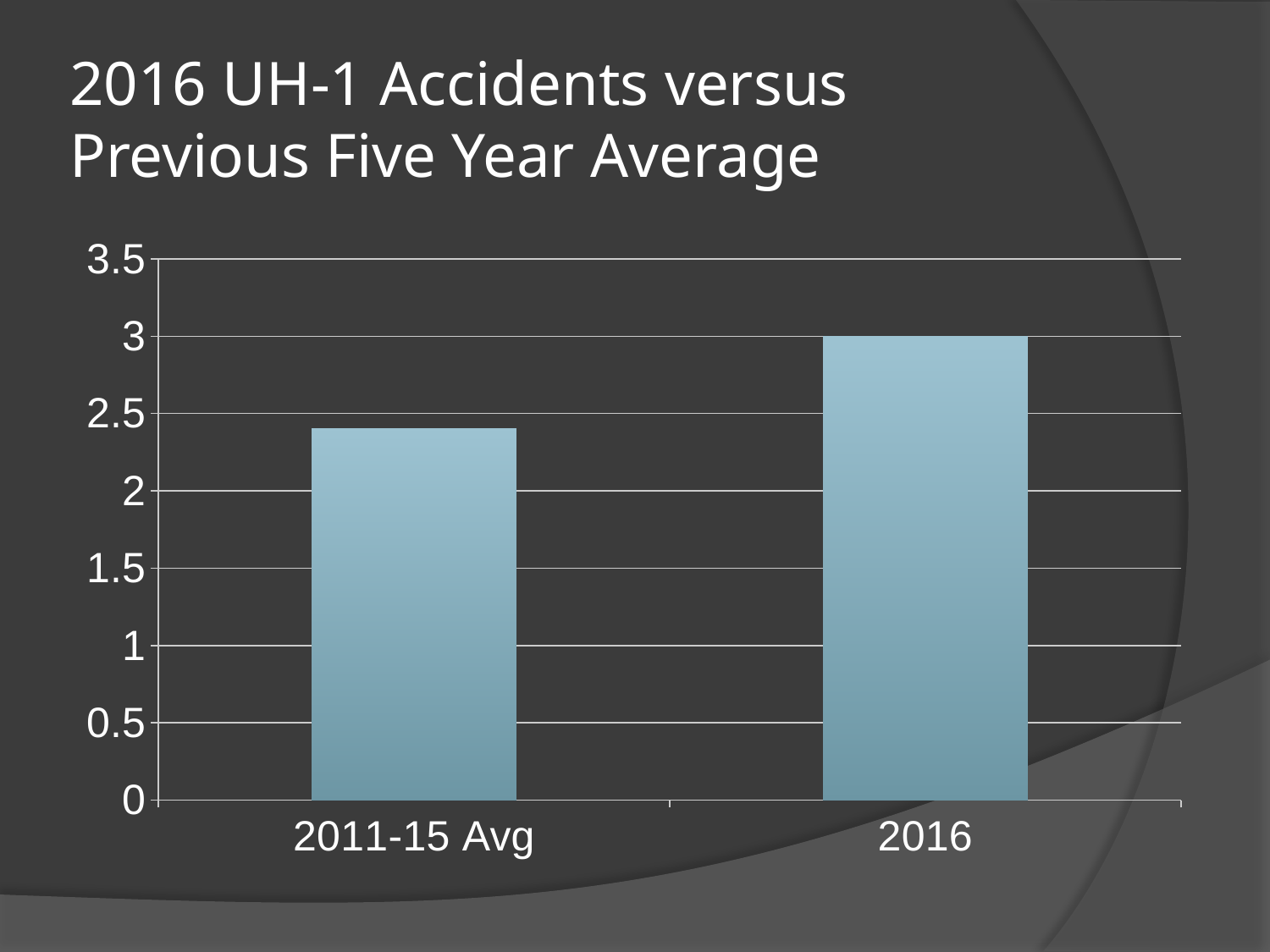
Is the value for 2011-15 Avg greater or less than 2.5? less Do the values rise or fall from 2011-15 Avg to 2016? rise What is the value for 2016? 3 What is the highest value shown on the vertical axis? 3.5 Is the value for 2011-15 Avg greater or less than 2? greater What kind of chart is shown on the slide? bar chart Which is larger, the value for 2011-15 Avg or the value for 2016? 2016 What is the title of the slide? 2016 UH-1 Accidents versus Previous Five Year Average How many categories are plotted on the chart? 2 Which category has the lowest value? 2011-15 Avg Which category has the highest value? 2016 Is the value for 2016 greater or less than 2.5? greater